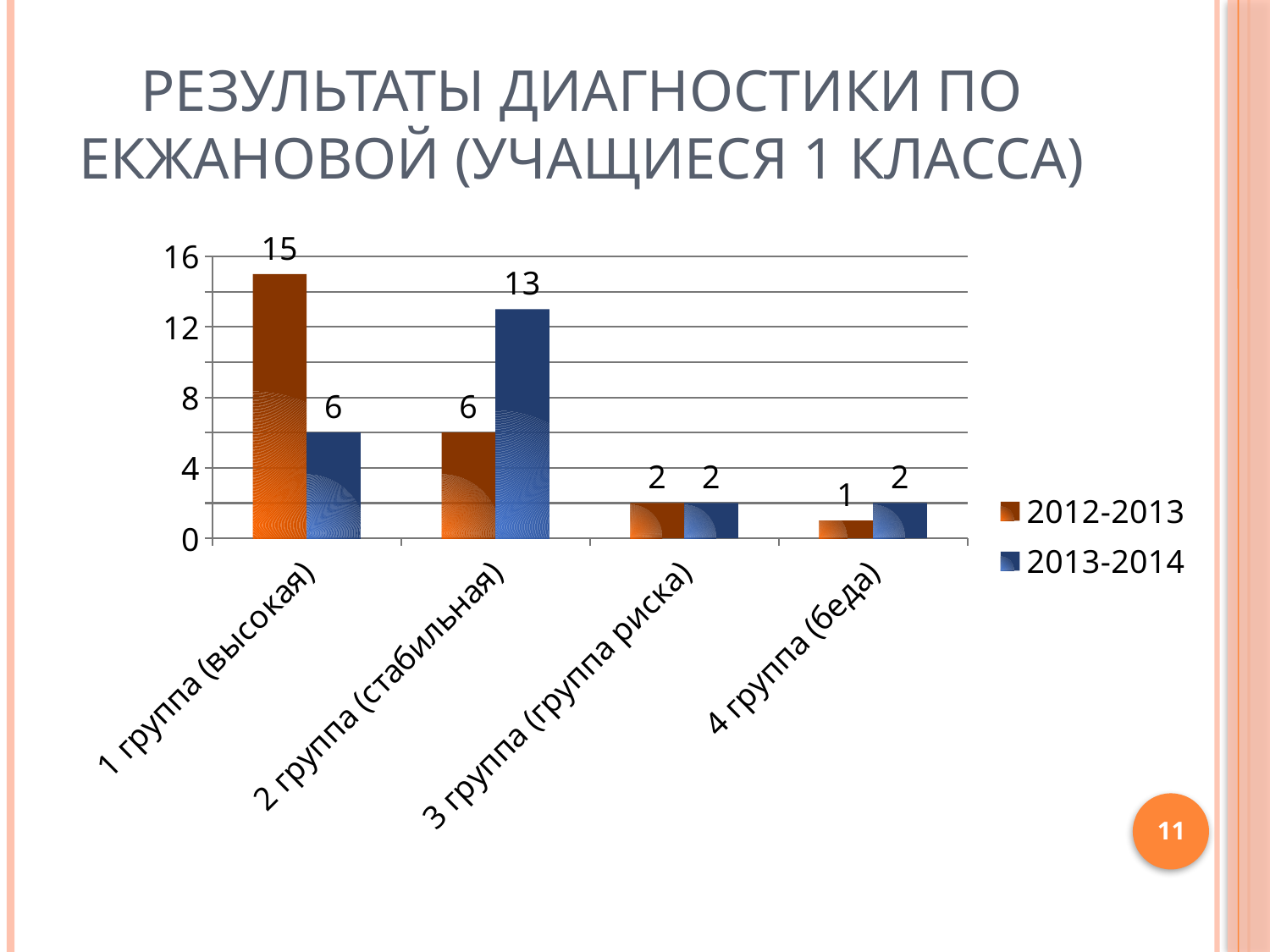
How many categories are shown on the x axis? 4 What kind of chart is shown on the slide? Bar chart Which category has the highest value for the 2013-2014 series? 2 группа (стабильная) What is the difference between the 2013-2014 and 2012-2013 values for "2 группа (стабильная)"? 7 Which colour represents the 2013-2014 series in the legend? Blue What is the value for 2013-2014 in the category "2 группа (стабильная)"? 13 What is the value for 2012-2013 in the category "4 группа (беда)"? 1 Which category has the lowest value for the 2012-2013 series? 4 группа (беда) What is the value for 2012-2013 in the category "1 группа (высокая)"? 15 How many series does the legend list? 2 What is the difference between the 2012-2013 and 2013-2014 values for "1 группа (высокая)"? 9 Which series has the larger value in "2 группа (стабильная)", 2012-2013 or 2013-2014? 2013-2014